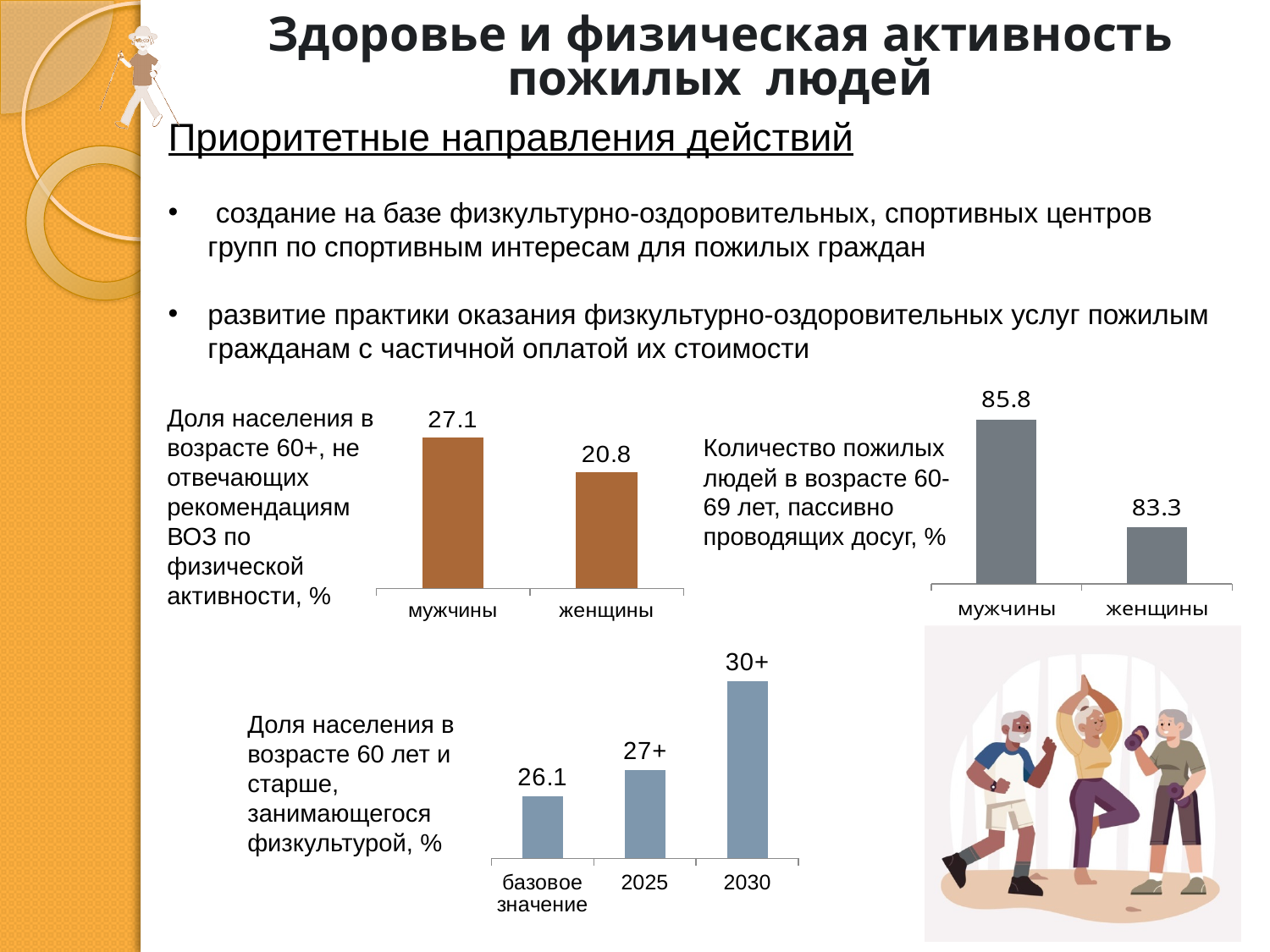
In the bottom chart (share of population aged 60 and older doing physical exercise), what is the value for базовое значение? 26.1 In the top-right chart (elderly people aged 60-69 spending leisure passively), which category has the higher value? мужчины In the top-right chart (elderly people aged 60-69 spending leisure passively), what is the difference between мужчины and женщины? 2.5 In the bottom chart (share of population aged 60 and older doing physical exercise), how many categories are shown on the x axis? 3 What type of chart is the top-left chart (share of population aged 60+ not meeting WHO recommendations)? bar chart In the top-right chart (elderly people aged 60-69 spending leisure passively), what is the value for женщины? 83.3 In the bottom chart (share of population aged 60 and older doing physical exercise), what is the value labelled for 2030? 30+ In the top-left chart (share of population aged 60+ not meeting WHO physical activity recommendations), what is the value for мужчины? 27.1 In the bottom chart (share of population aged 60 and older doing physical exercise), do the values rise or fall from базовое значение to 2030? rise In the top-left chart (share of population aged 60+ not meeting WHO physical activity recommendations), what is the value for женщины? 20.8 In the top-right chart (elderly people aged 60-69 spending leisure passively), what is the value for мужчины? 85.8 In the top-left chart (share of population aged 60+ not meeting WHO recommendations), what is the difference between the values for мужчины and женщины? 6.3